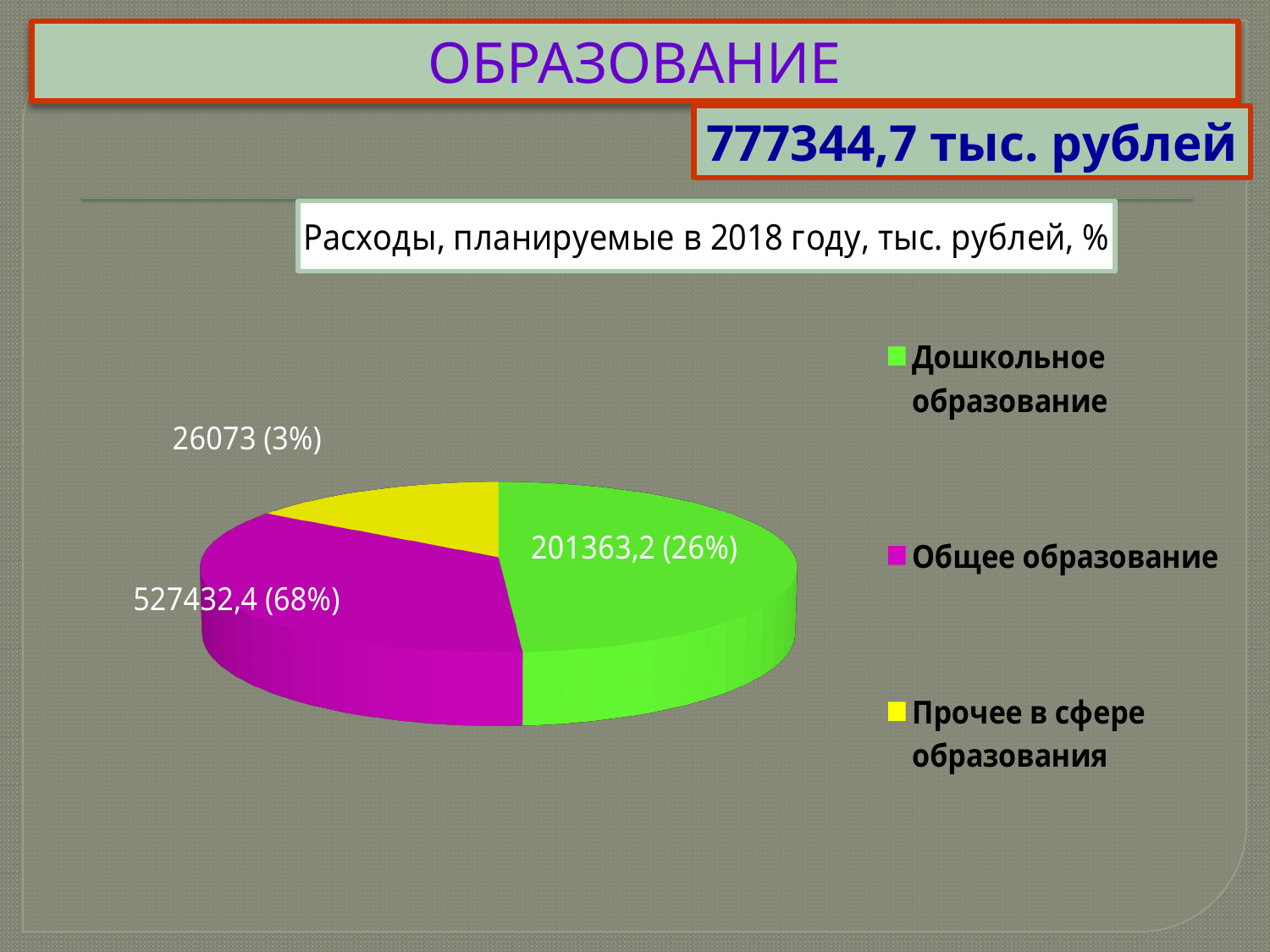
What is the value for Дошкольное образование? 201363,2 What share of the pie does Дошкольное образование take? 26% What kind of chart is shown on the slide? Pie chart What is the value for Прочее в сфере образования? 26073 What is the title of the chart? Расходы, планируемые в 2018 году, тыс. рублей, % What is the difference between the values for Общее образование and Дошкольное образование? 326069,2 What share of the pie does Общее образование take? 68% Which category has the smallest slice? Прочее в сфере образования What is the value for Общее образование? 527432,4 What share of the pie does Прочее в сфере образования take? 3% How many slices does the pie chart have? 3 Which category has the largest slice? Общее образование